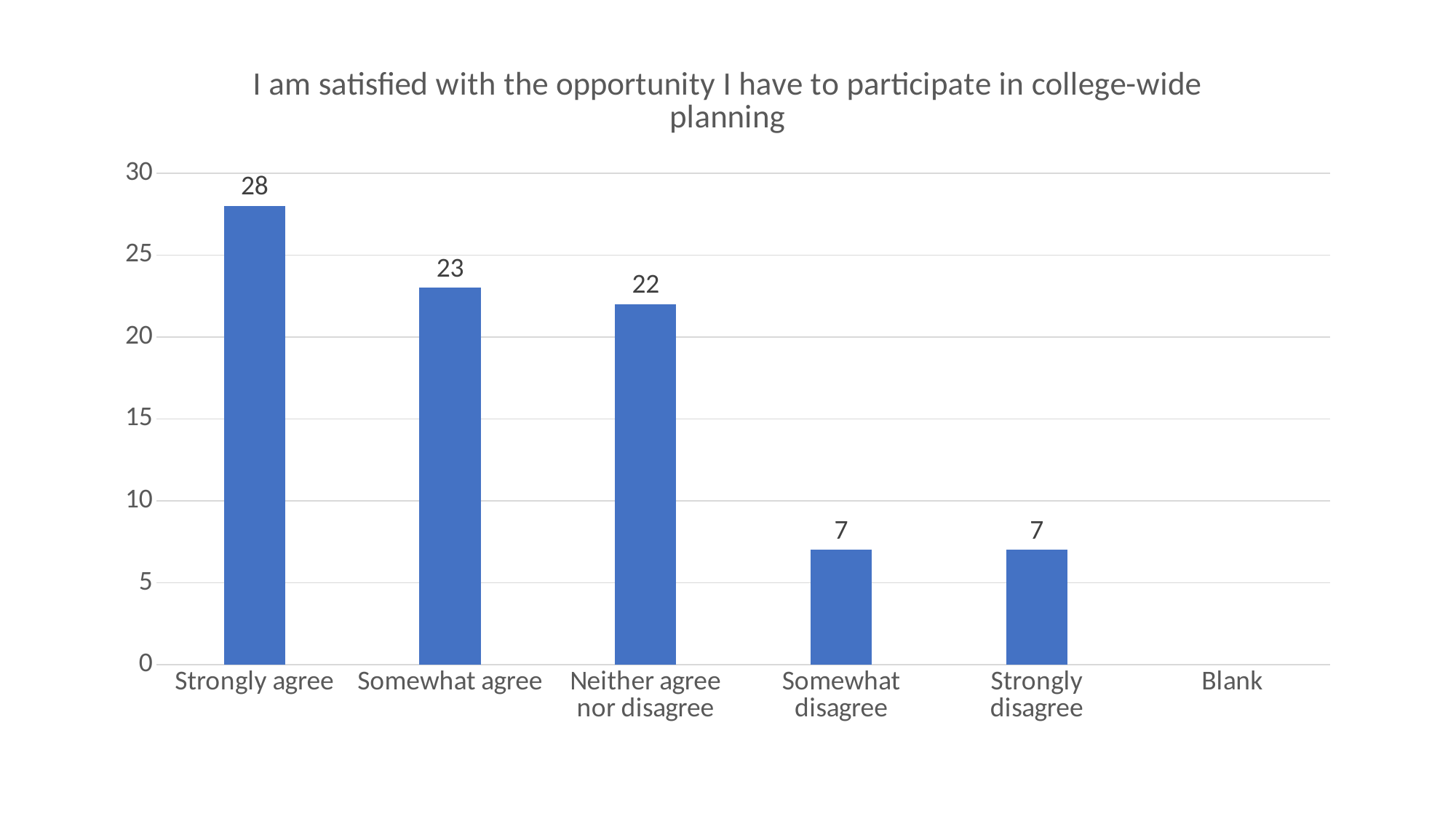
How many categories are shown on the x axis? 6 What is the value for Somewhat agree? 23 What is the difference between the values for Strongly agree and Somewhat agree? 5 Which is larger, the value for Somewhat agree or the value for Neither agree nor disagree? Somewhat agree What is the value for Neither agree nor disagree? 22 What is the value for Strongly agree? 28 What is the difference between the values for Somewhat agree and Strongly disagree? 16 What kind of chart is this? bar chart Is the value for Strongly agree greater or less than 25? greater What is the value for Somewhat disagree? 7 What is the title of the chart? I am satisfied with the opportunity I have to participate in college-wide planning Which category has the highest value? Strongly agree